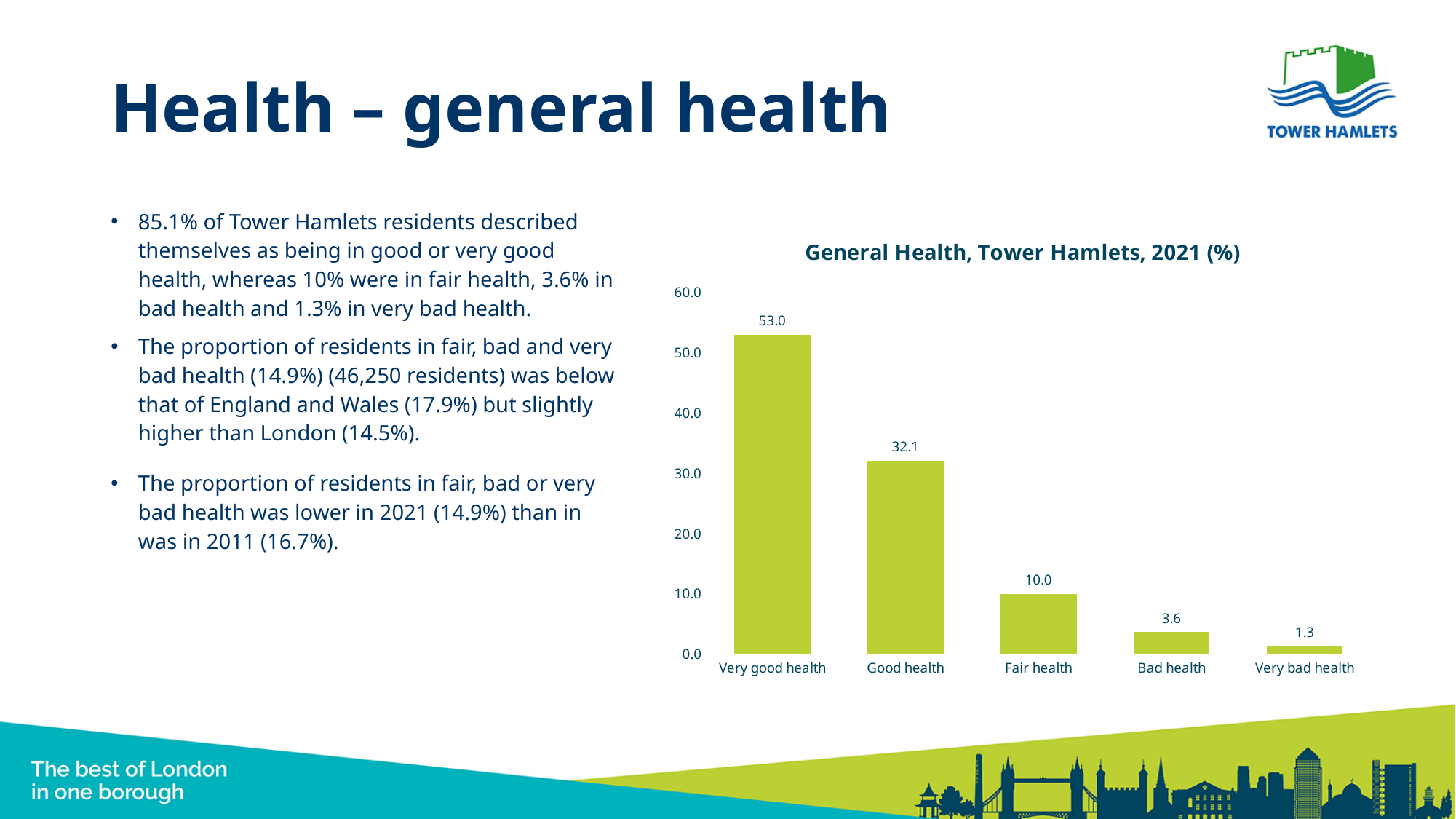
What is the value for Bad health? 3.6 What kind of chart is shown on the slide? Bar chart How many categories are shown on the x axis? 5 Which is larger, the value for Fair health or the value for Bad health? Fair health What is the value for Fair health? 10.0 What is the title of the chart? General Health, Tower Hamlets, 2021 (%) What is the value for Very bad health? 1.3 Which category has the highest value? Very good health What is the value for Very good health? 53.0 What is the value for Good health? 32.1 What is the difference between the values for Very good health and Good health? 20.9 Which category has the lowest value? Very bad health